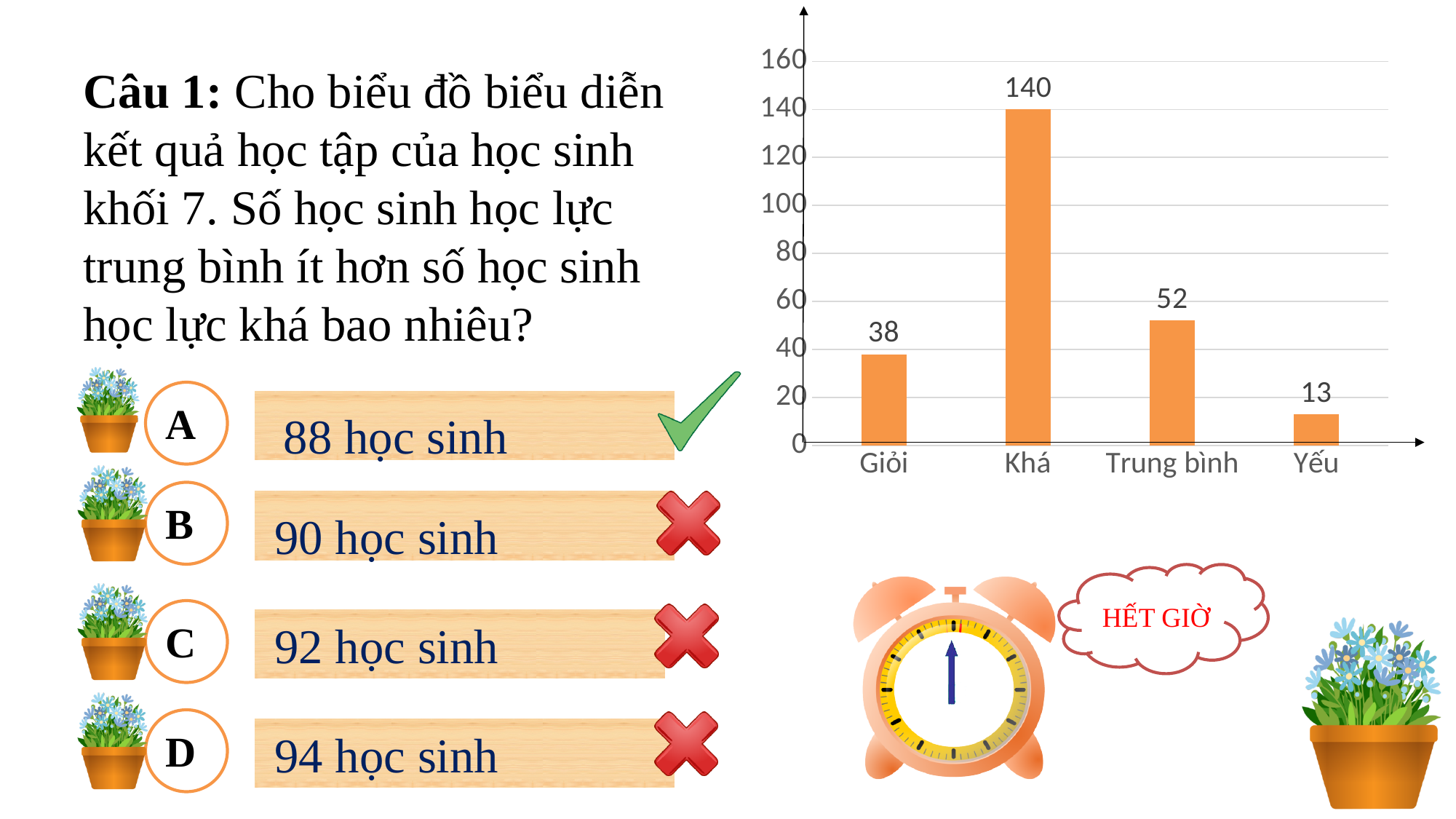
What is the difference between the values for Trung bình and Giỏi? 14 What is the value for Khá? 140 Which category has the lowest value? Yếu What is the difference between the values for Khá and Trung bình? 88 What is the value for Trung bình? 52 Which is larger, the value for Giỏi or the value for Trung bình? Trung bình Is the value for Khá greater or less than 120? greater Which category has the highest value? Khá What is the value for Yếu? 13 What kind of chart is shown on the slide? bar chart How many categories are shown on the x axis? 4 What is the value for Giỏi? 38